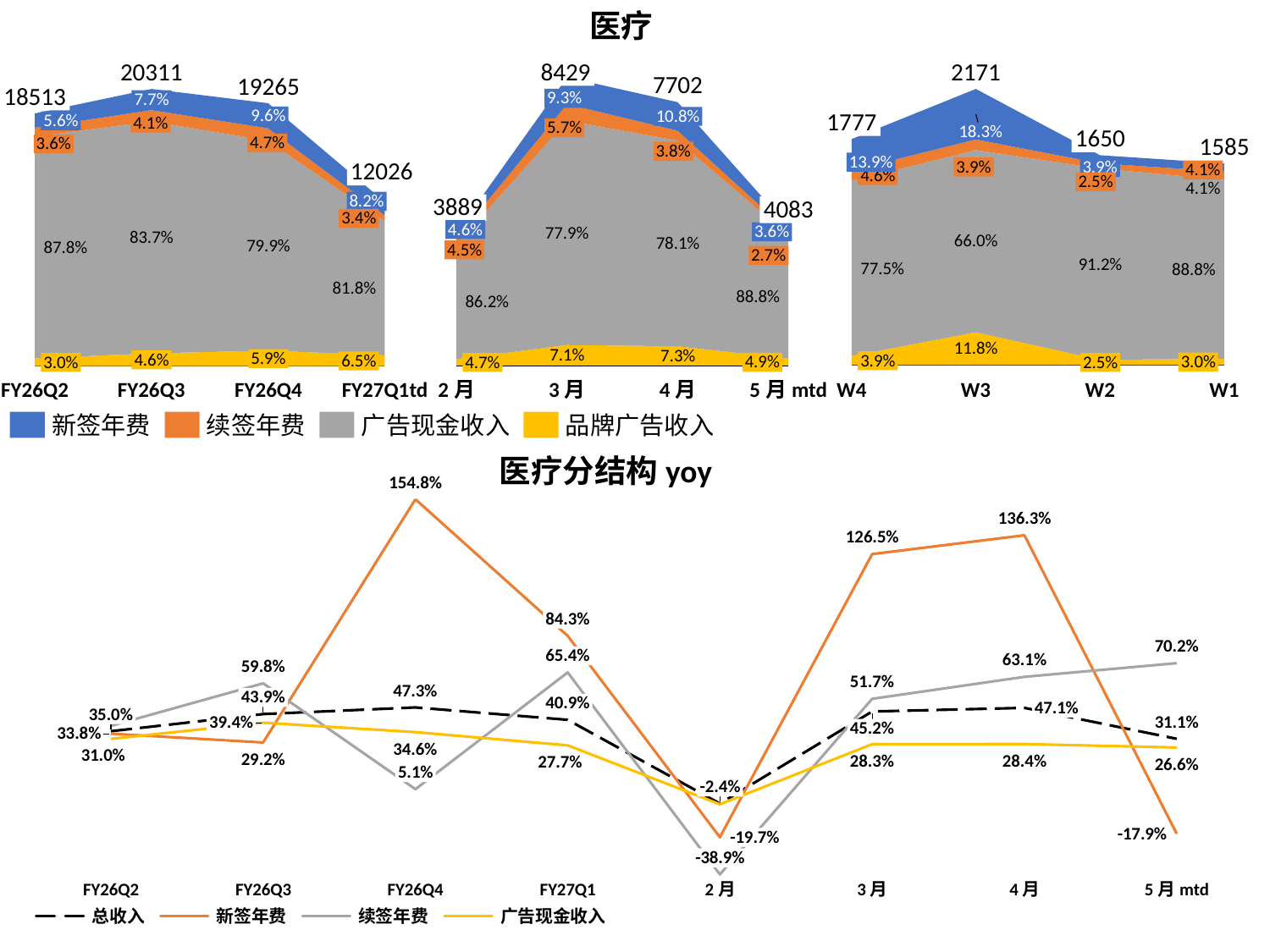
In the top chart titled 医疗, which of the months 2月, 3月, 4月 and 5月 mtd has the highest total? 3月 In the bottom chart titled 医疗分结构 yoy, at which period is the 新签年费 value lowest? 2月 In the top chart titled 医疗, what is the total value shown for FY26Q3? 20311 What kind of chart is the bottom chart titled 医疗分结构 yoy? Line chart How many series does the legend of the top chart titled 医疗 list? 4 In the top chart titled 医疗, which has the larger total, W4 or W1? W4 In the bottom chart titled 医疗分结构 yoy, what is the 总收入 value at 2月? -2.4% In the bottom chart titled 医疗分结构 yoy, what is the 续签年费 value at 5月 mtd? 70.2% In the top chart titled 医疗, what percentage does 品牌广告收入 account for in W3? 11.8% In the top chart titled 医疗, what percentage does 广告现金收入 account for in W3? 66.0% In the bottom chart titled 医疗分结构 yoy, what is the 新签年费 value at FY26Q4? 154.8% In the top chart titled 医疗, what is the difference between the totals for FY26Q3 and FY26Q2? 1798